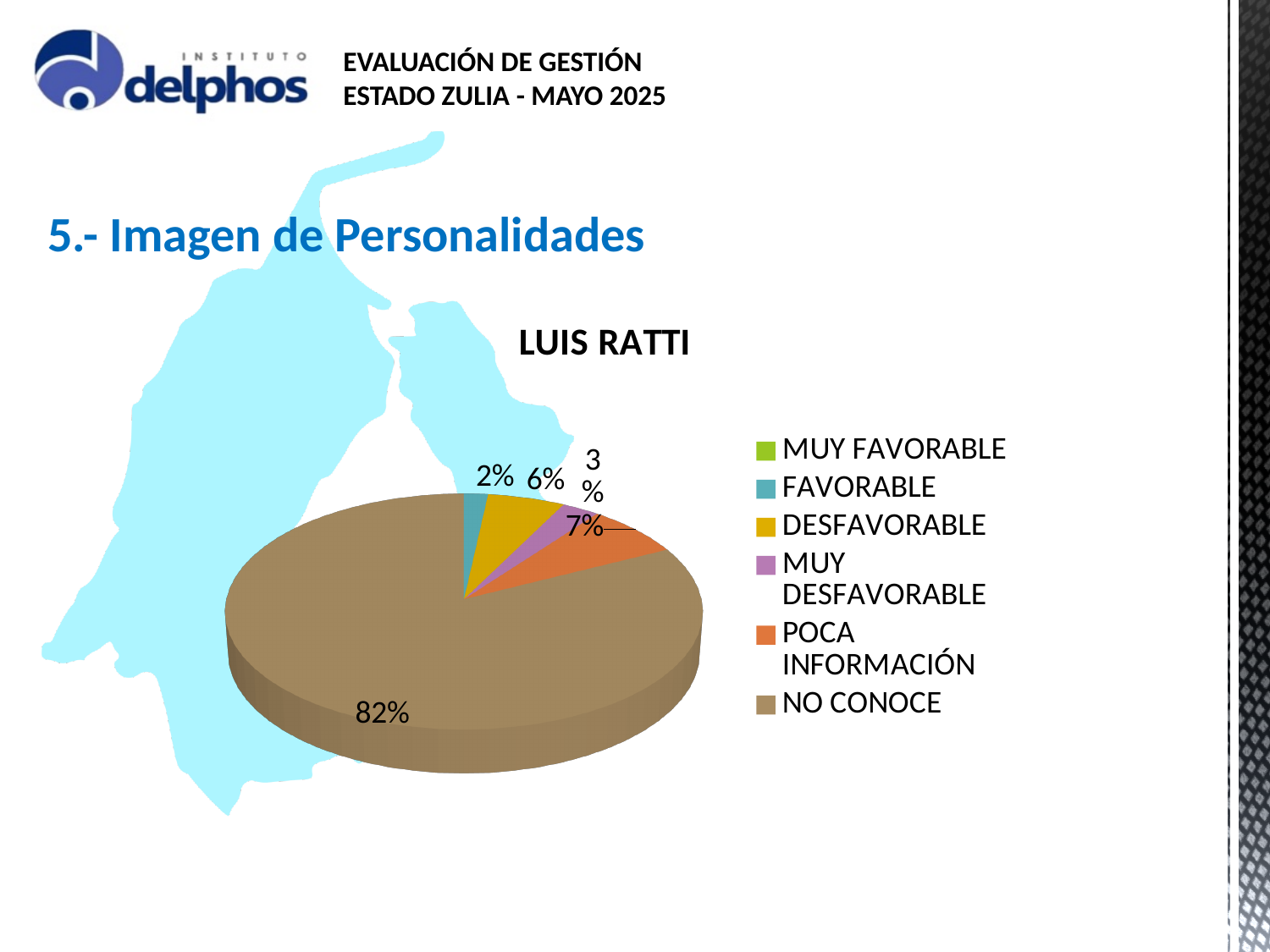
Which category has the largest slice of the pie? NO CONOCE What kind of chart is shown on the slide? Pie chart What is the difference in percentage points between the NO CONOCE slice and the POCA INFORMACIÓN slice? 75 What percentage of the pie corresponds to POCA INFORMACIÓN? 7% What percentage of the pie corresponds to FAVORABLE? 2% How many categories does the legend list? 6 What percentage of the pie corresponds to DESFAVORABLE? 6% What is the title of the chart? LUIS RATTI What percentage of the pie corresponds to MUY DESFAVORABLE? 3% Which is larger, the DESFAVORABLE slice or the POCA INFORMACIÓN slice? POCA INFORMACIÓN What is the combined percentage of the DESFAVORABLE and MUY DESFAVORABLE slices? 9% What percentage of the pie is labelled NO CONOCE? 82%